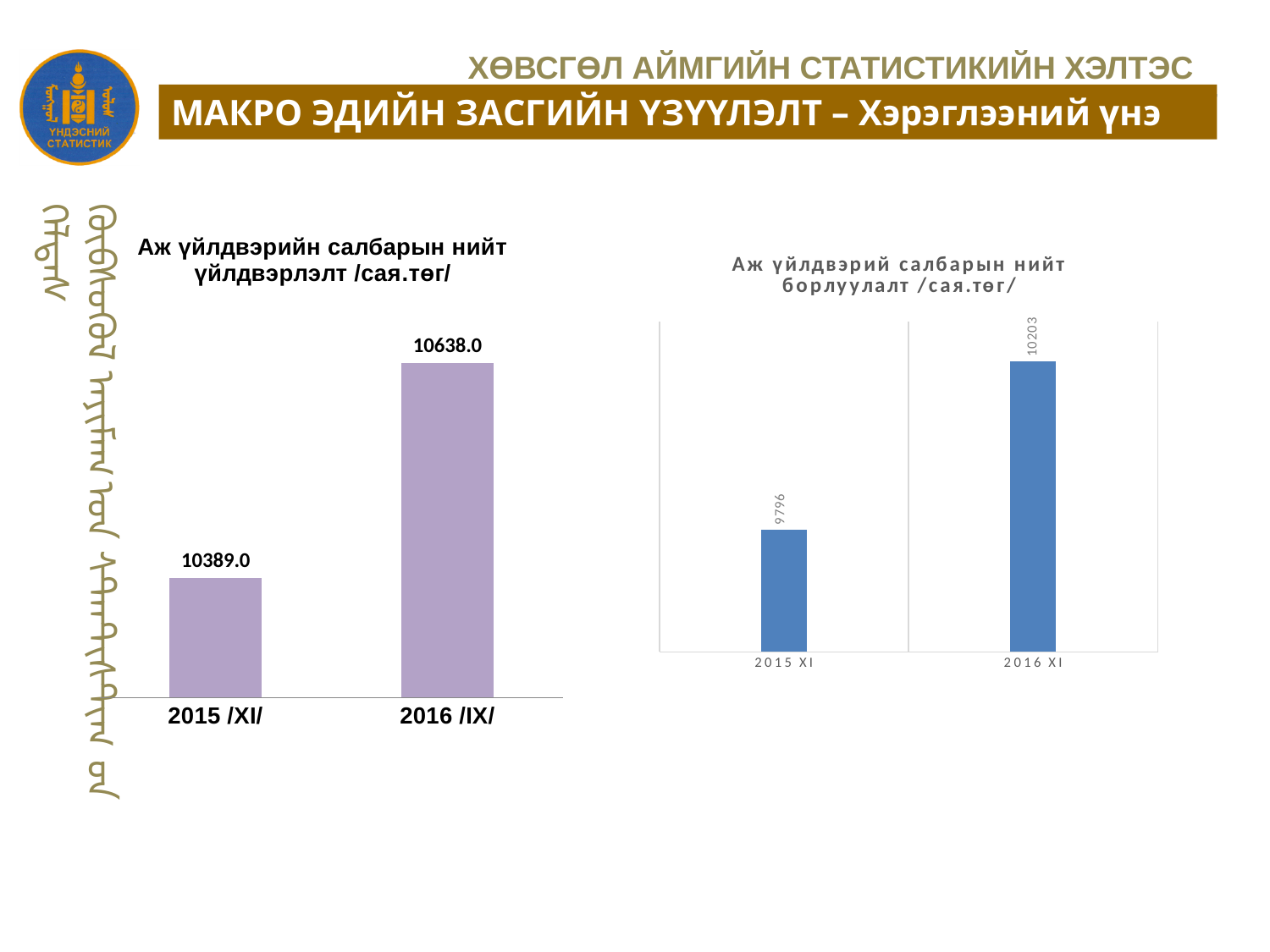
In the left chart (Аж үйлдвэрийн салбарын нийт үйлдвэрлэлт /сая.төг/), do the values rise or fall from 2015 /XI/ to 2016 /IX/? Rise In the left chart (Аж үйлдвэрийн салбарын нийт үйлдвэрлэлт /сая.төг/), which period has the higher value? 2016 /IX/ In the left chart (Аж үйлдвэрийн салбарын нийт үйлдвэрлэлт /сая.төг/), what is the difference between the 2016 /IX/ and 2015 /XI/ values? 249.0 What type of chart is the right chart (Аж үйлдвэрий салбарын нийт борлуулалт /сая.төг/)? Bar chart In the left chart (Аж үйлдвэрийн салбарын нийт үйлдвэрлэлт /сая.төг/), what is the value for 2016 /IX/? 10638.0 In the right chart (Аж үйлдвэрий салбарын нийт борлуулалт /сая.төг/), what is the value for 2015 XI? 9796 In the right chart (Аж үйлдвэрий салбарын нийт борлуулалт /сая.төг/), what is the difference between the 2016 XI and 2015 XI values? 407 In the right chart (Аж үйлдвэрий салбарын нийт борлуулалт /сая.төг/), is the value for 2016 XI larger or smaller than the value for 2015 XI? larger In the right chart (Аж үйлдвэрий салбарын нийт борлуулалт /сая.төг/), what is the value for 2016 XI? 10203 In the left chart (Аж үйлдвэрийн салбарын нийт үйлдвэрлэлт /сая.төг/), what is the value for 2015 /XI/? 10389.0 In the right chart (Аж үйлдвэрий салбарын нийт борлуулалт /сая.төг/), which period has the lower value? 2015 XI How many bars are plotted in the left chart (Аж үйлдвэрийн салбарын нийт үйлдвэрлэлт /сая.төг/)? 2